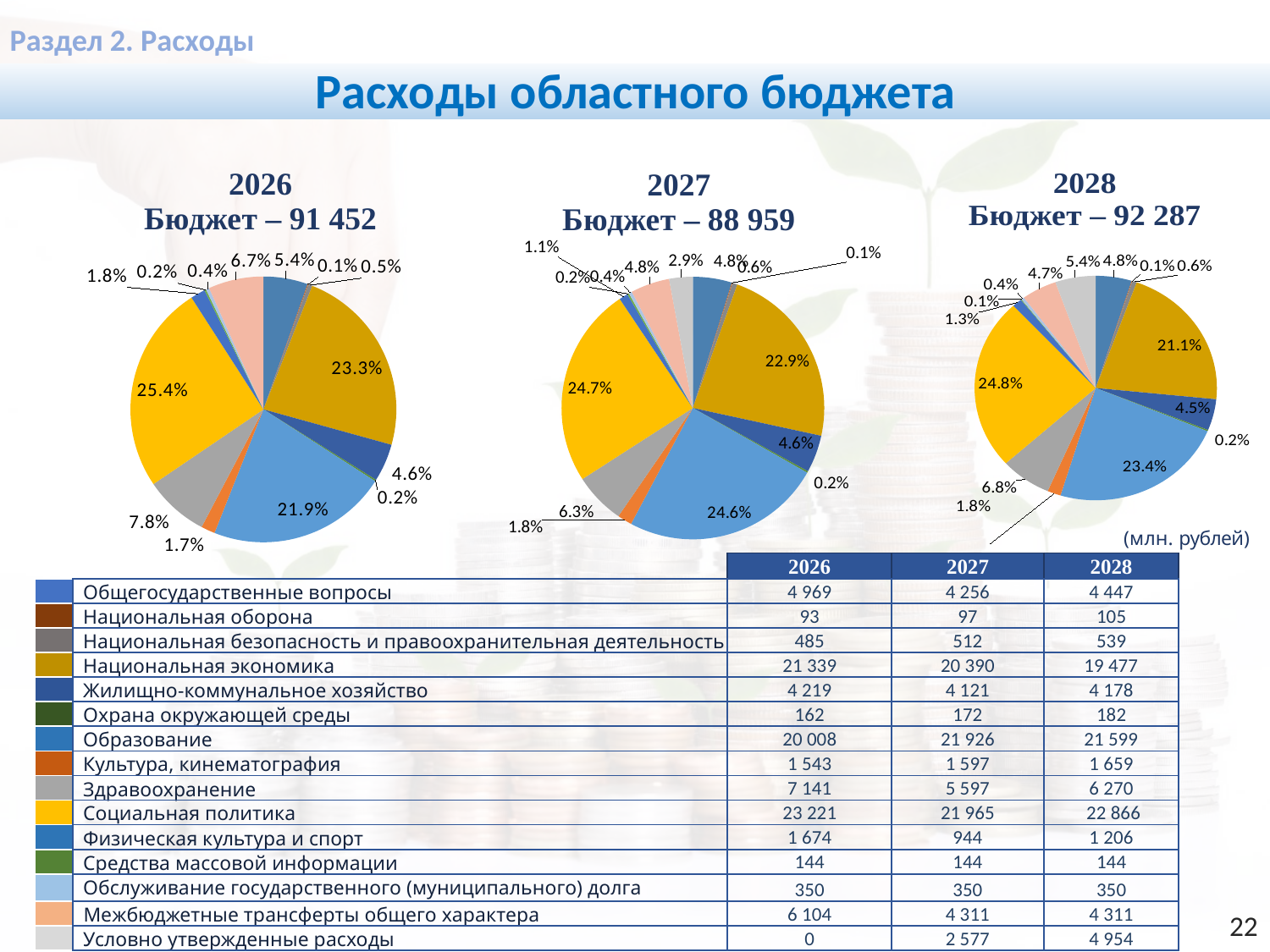
How many expenditure categories are listed in the table below the pie charts? 15 How many pie charts are on the slide? 3 What type of charts are shown on the slide for 2026, 2027 and 2028? Pie charts According to the table, what is the value for Образование in 2027? 21 926 What is the total budget shown in the title of the 2028 pie chart? 92 287 In the 2026 pie chart, what is the largest share shown? 25.4% According to the table, what is the difference between Здравоохранение in 2026 and in 2027? 1 544 What is the total budget shown in the title of the 2027 pie chart? 88 959 In the 2028 pie chart, what is the largest share shown? 24.8% In the 2027 pie chart, what is the largest share shown? 24.7% In the 2026 pie chart, what share does the blue Образование slice (21.9%) have compared with the grey Здравоохранение slice (7.8%) — which is larger? Образование (21.9%) According to the table, what is the value for Социальная политика in 2028? 22 866